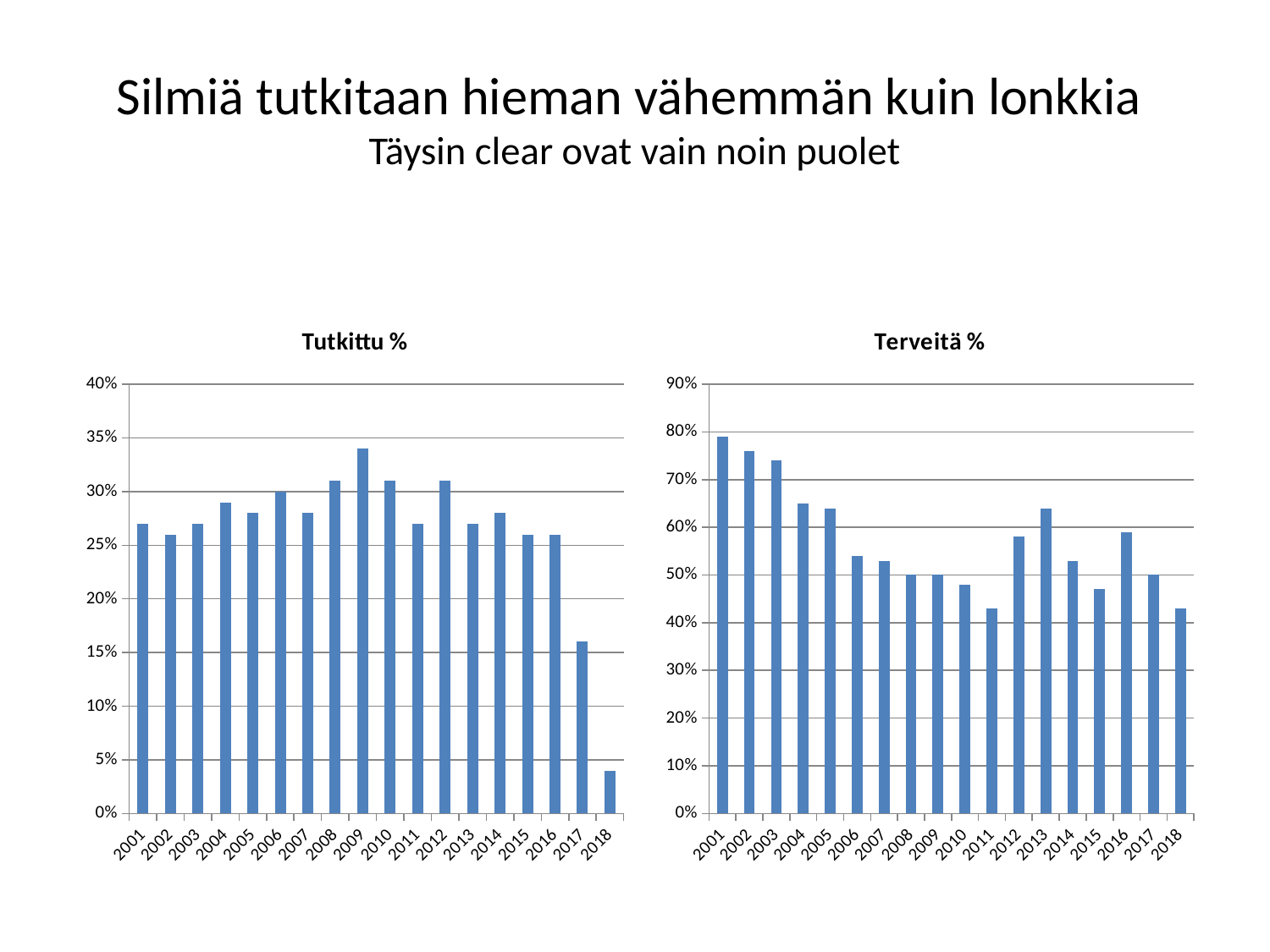
In the 'Terveitä %' chart, is the value for 2011 greater or less than 50%? less In the 'Terveitä %' chart, which year has the highest value? 2001 In the 'Terveitä %' chart, do the values generally rise or fall from 2001 to 2011? fall What is the title of the chart on the right side of the slide? Terveitä % In the 'Tutkittu %' chart, which is larger, the value for 2004 or the value for 2018? 2004 In the 'Tutkittu %' chart, which year has the highest value? 2009 In the 'Tutkittu %' chart, is the value for 2009 greater or less than 30%? greater How many years are shown on the x axis of the 'Tutkittu %' chart? 18 In the 'Tutkittu %' chart, which year has the lowest value? 2018 What kind of chart is the 'Tutkittu %' chart? bar chart In the 'Terveitä %' chart, is the value for 2001 greater or less than 70%? greater